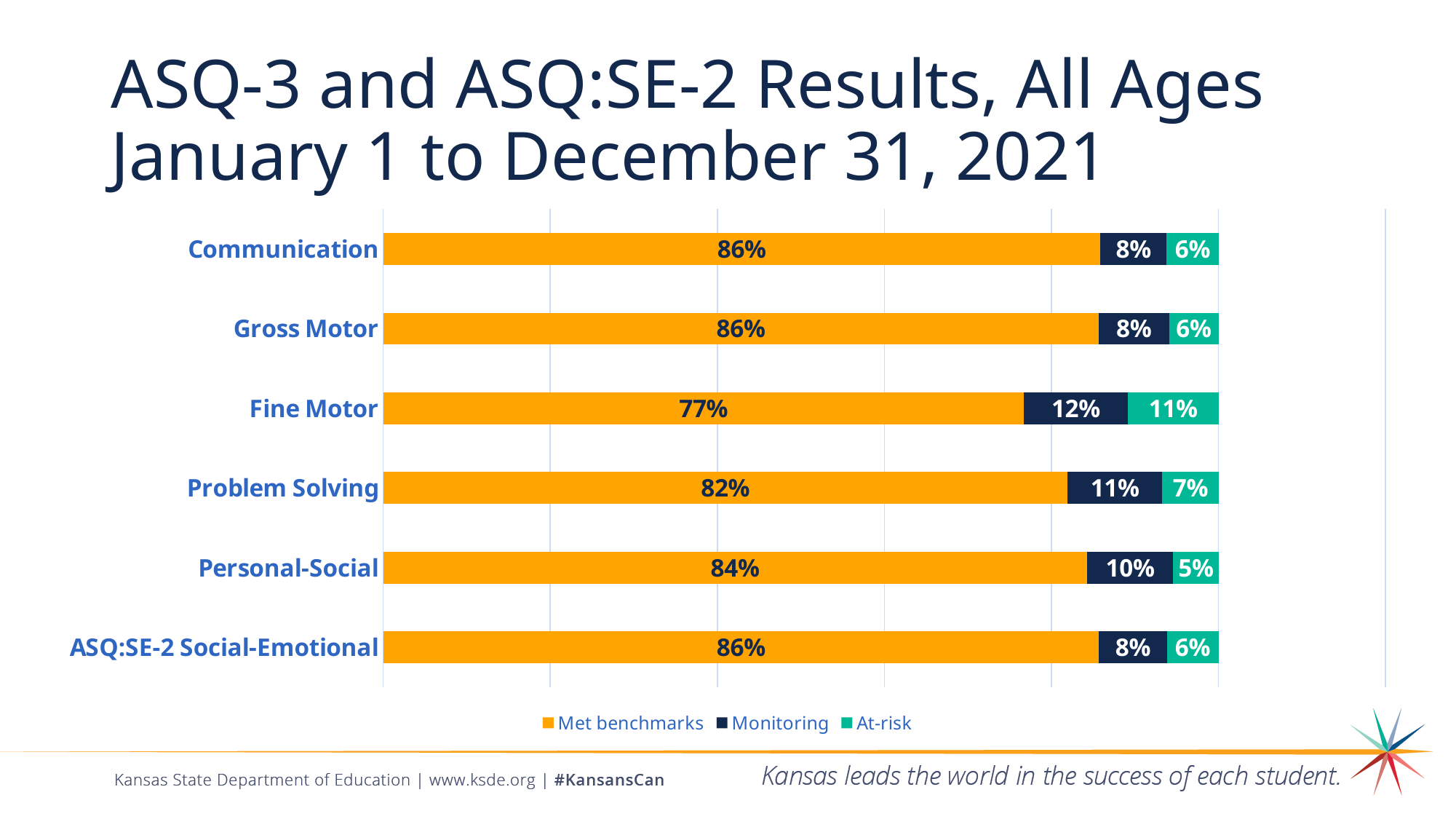
Which category has the highest At-risk percentage? Fine Motor Which is larger, the Monitoring value for Personal-Social or the Monitoring value for Gross Motor? Personal-Social Which colour represents the At-risk series in the chart? Green What is the difference between the Met benchmarks values for Communication and Fine Motor? 9% What is the Met benchmarks value for ASQ:SE-2 Social-Emotional? 86% How many series does the legend list? 3 What kind of chart is shown on the slide? Stacked bar chart How many categories are shown on the chart? 6 What is the Monitoring value for Problem Solving? 11% Which category has the lowest Met benchmarks percentage? Fine Motor What is the At-risk value for Personal-Social? 5% What percentage of Fine Motor results met benchmarks? 77%